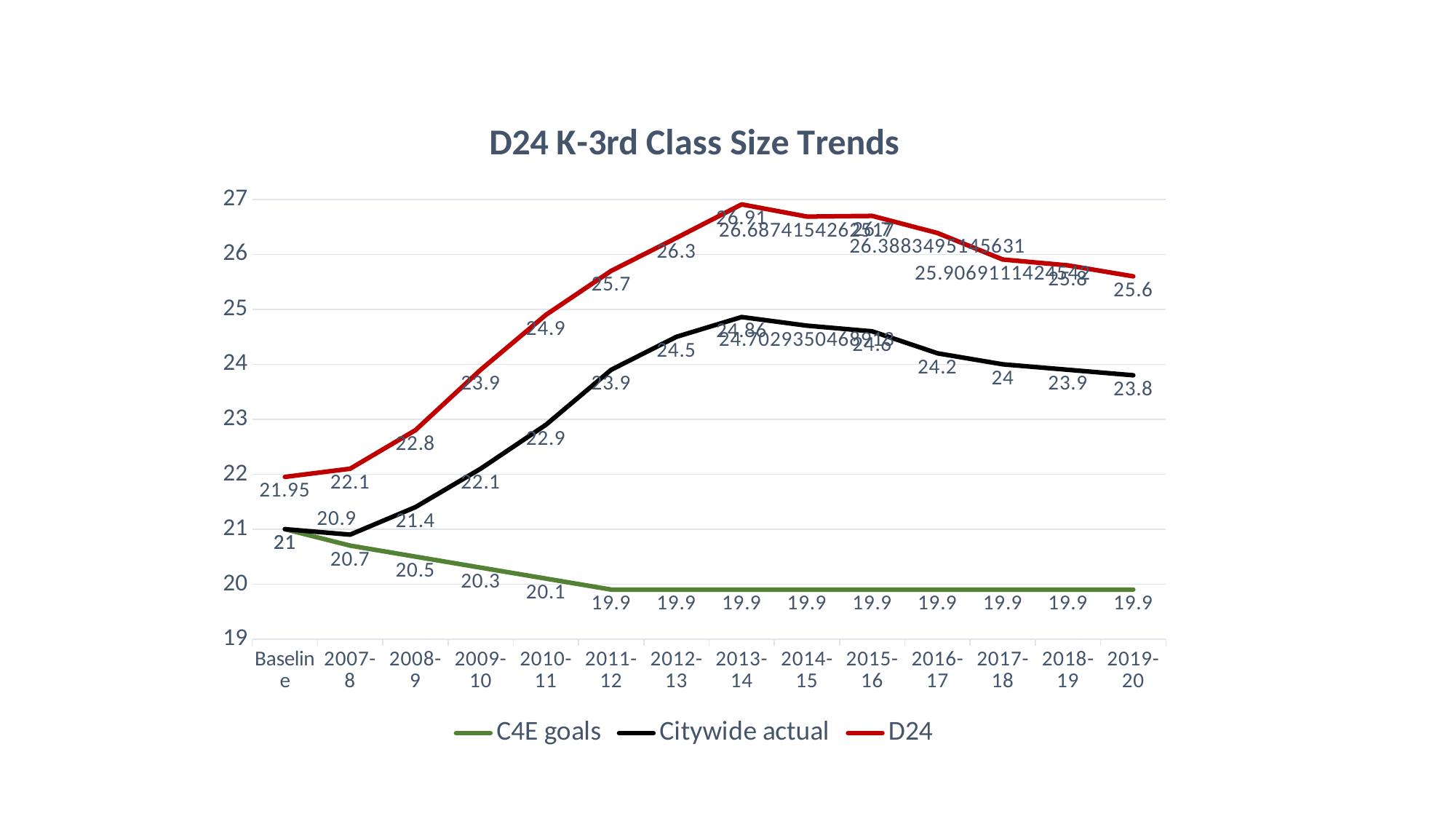
What kind of chart is shown on the slide? line chart In which year is the D24 value highest? 2013-14 What is the Citywide actual value for 2016-17? 24.2 What is the D24 value for 2019-20? 25.6 How many series does the legend list? 3 How many points along the x axis does the chart have? 14 What is the difference between the D24 value and the Citywide actual value in 2019-20? 1.8 Which is larger in 2012-13, the D24 value or the Citywide actual value? D24 What is the C4E goals value for 2008-9? 20.5 Is the Citywide actual value for 2013-14 greater or less than 24? greater What is the title of the chart? D24 K-3rd Class Size Trends Does the D24 series rise or fall from Baseline to 2013-14? rise